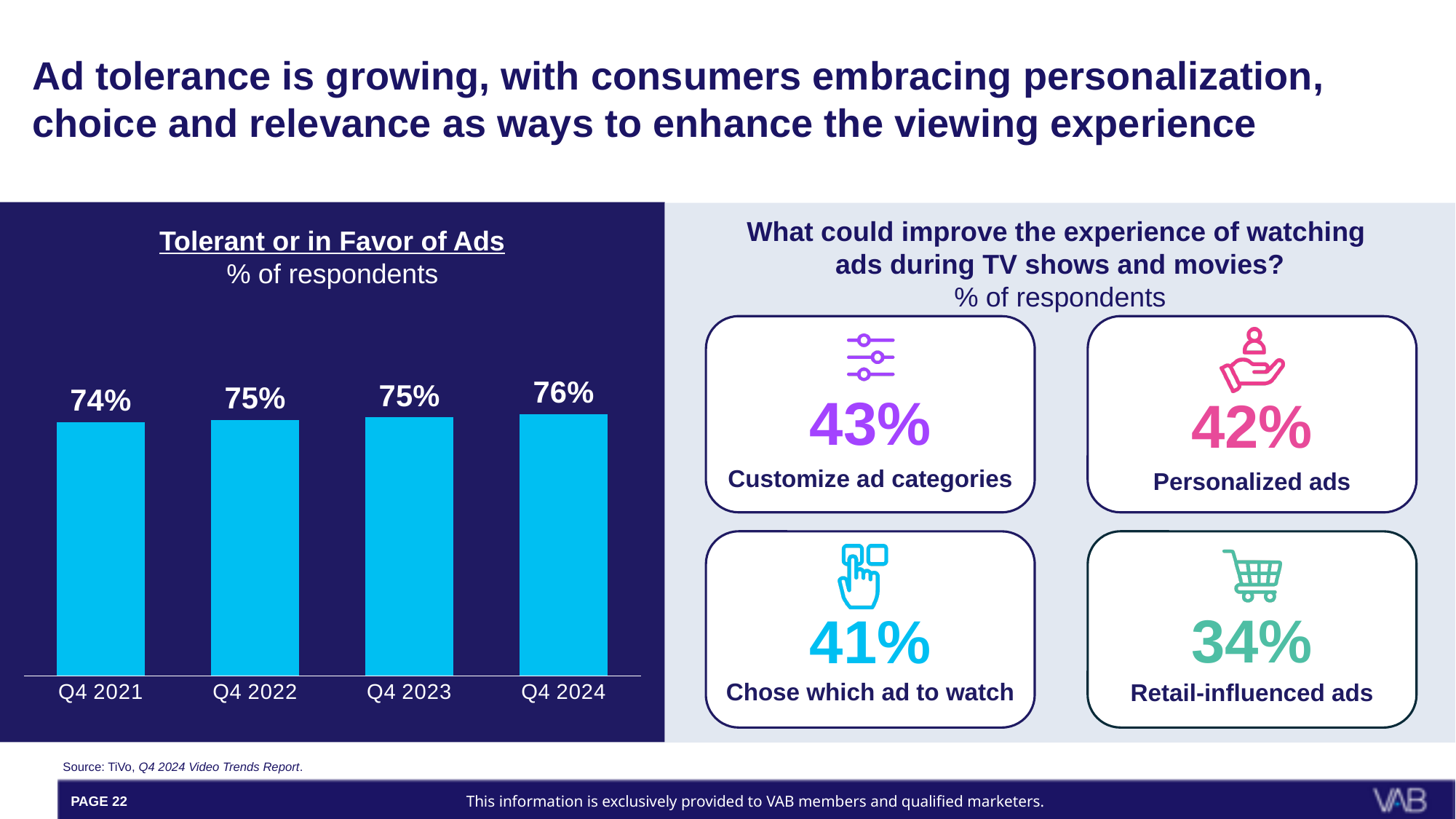
In the 'Tolerant or in Favor of Ads' chart, what is the value for Q4 2024? 76% In the 'Tolerant or in Favor of Ads' chart, do the values rise or fall from Q4 2021 to Q4 2024? Rise In the 'Tolerant or in Favor of Ads' chart, what is the value for Q4 2021? 74% In the right-hand panel 'What could improve the experience of watching ads during TV shows and movies?', which option has the lowest percentage? Retail-influenced ads In the 'Tolerant or in Favor of Ads' chart, what is the value for Q4 2022? 75% In the 'Tolerant or in Favor of Ads' chart, what unit is shown in the subtitle under the chart title? % of respondents In the 'Tolerant or in Favor of Ads' chart, which quarter has the highest value? Q4 2024 In the right-hand panel 'What could improve the experience of watching ads during TV shows and movies?', what percentage is shown for 'Customize ad categories'? 43% What kind of chart is the 'Tolerant or in Favor of Ads' chart? Bar chart In the 'Tolerant or in Favor of Ads' chart, how many quarters are shown on the x axis? 4 In the 'Tolerant or in Favor of Ads' chart, which quarter has the lowest value? Q4 2021 In the 'Tolerant or in Favor of Ads' chart, what is the difference between the Q4 2024 and Q4 2021 values? 2%